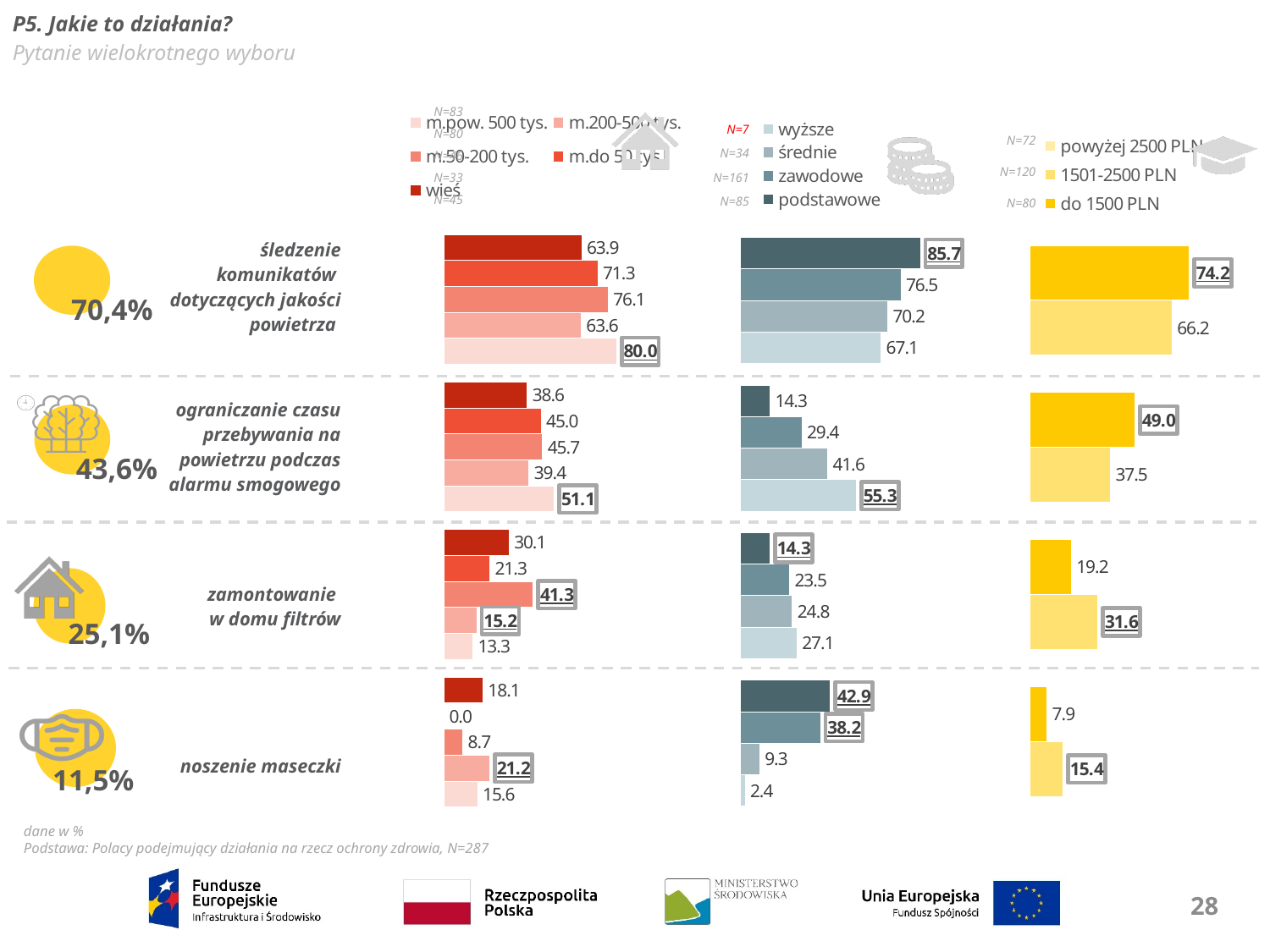
In the chart by education for 'noszenie maseczki', what is the difference between the values for 'podstawowe' and 'zawodowe'? 4.7 What kind of chart is used to show the results on this slide? bar chart In the chart by education for 'śledzenie komunikatów dotyczących jakości powietrza', what is the value for 'podstawowe'? 85.7 What overall percentage is shown for 'ograniczanie czasu przebywania na powietrzu podczas alarmu smogowego'? 43,6% In the chart by place of residence for 'śledzenie komunikatów dotyczących jakości powietrza', what is the value for 'm.pow. 500 tys.'? 80.0 In the chart by education for 'ograniczanie czasu przebywania na powietrzu podczas alarmu smogowego', which education category has the highest value? wyższe In the chart by education for 'zamontowanie w domu filtrów', what is the value for 'wyższe'? 27.1 How many categories does the legend for the education charts list? 4 In the chart by place of residence for 'zamontowanie w domu filtrów', what is the difference between the values for 'm.50-200 tys.' and 'm.pow. 500 tys.'? 28.0 In the chart by place of residence for 'noszenie maseczki', which category has the lowest value? m.do 50 tys. In the chart by education for 'noszenie maseczki', which is larger: the value for 'podstawowe' or the value for 'wyższe'? podstawowe How many categories does the legend for the place-of-residence charts list? 5